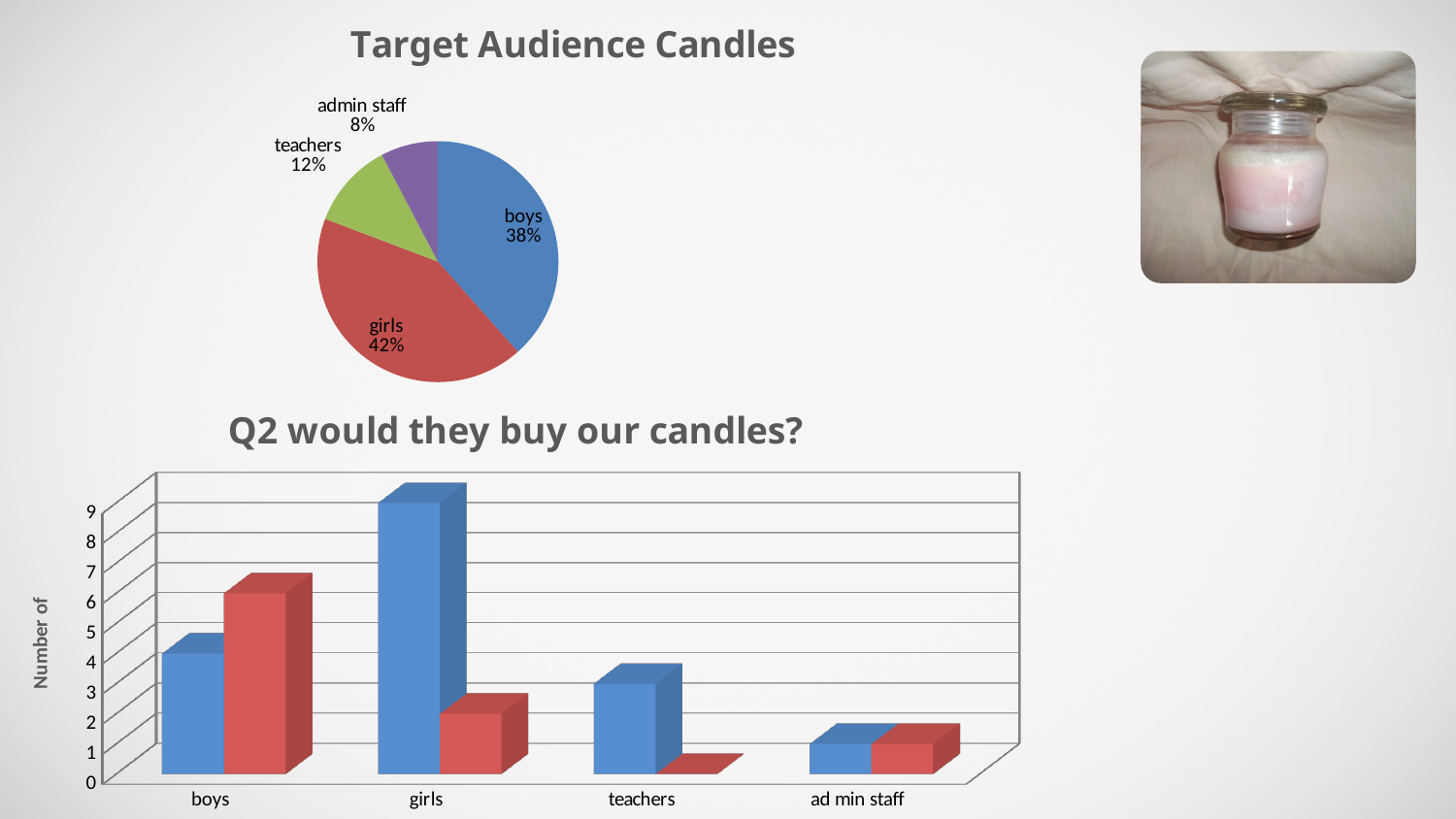
What kind of chart is the chart titled 'Q2 would they buy our candles?'? bar chart In the bar chart titled 'Q2 would they buy our candles?', is the value of the red bar for girls greater or less than 4? less In the pie chart titled 'Target Audience Candles', what percentage is shown for admin staff? 8% How many slices does the pie chart titled 'Target Audience Candles' have? 4 In the bar chart titled 'Q2 would they buy our candles?', is the value of the blue bar for girls greater or less than 7? greater In the bar chart titled 'Q2 would they buy our candles?', how many categories are shown on the x axis? 4 In the pie chart titled 'Target Audience Candles', which category has the smallest share? admin staff In the pie chart titled 'Target Audience Candles', which is larger, the share for teachers or the share for admin staff? teachers In the pie chart titled 'Target Audience Candles', which category has the largest share? girls In the bar chart titled 'Q2 would they buy our candles?', which category has the tallest bar? girls In the pie chart titled 'Target Audience Candles', what percentage is shown for girls? 42% In the pie chart titled 'Target Audience Candles', what is the difference in percentage points between girls and boys? 4